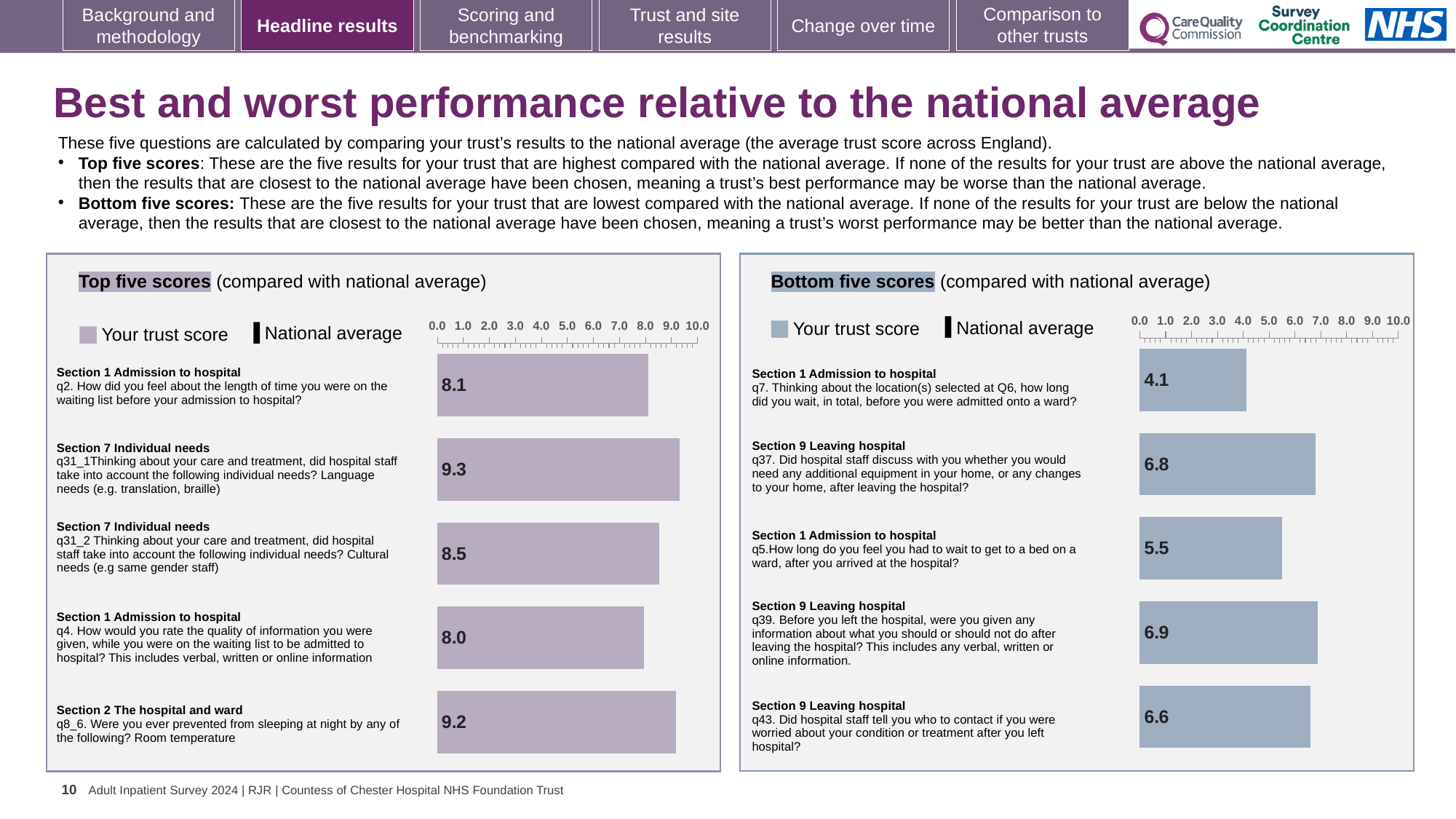
What kind of chart is the Top five scores chart? Bar chart In the Top five scores chart, is the trust score for q8_6 (Room temperature) greater or less than 9.0? greater In the Top five scores chart, what is the difference between the trust scores for q31_1 and q4? 1.3 How many series does the legend of the Top five scores chart list? 2 In the Bottom five scores chart, which question has the lowest trust score? q7 In the Top five scores chart, what is the trust score for q31_2 (Cultural needs)? 8.5 In the Top five scores chart, what is the trust score for q31_1 (Language needs)? 9.3 In the Bottom five scores chart, which has the larger trust score, q37 or q43? q37 How many questions are shown in the Bottom five scores chart? 5 In the Top five scores chart, which question has the highest trust score? q31_1 (Language needs) In the Bottom five scores chart, what is the trust score for q7 (how long did you wait before being admitted onto a ward)? 4.1 In the Bottom five scores chart, what is the difference between the trust scores for q39 and q7? 2.8